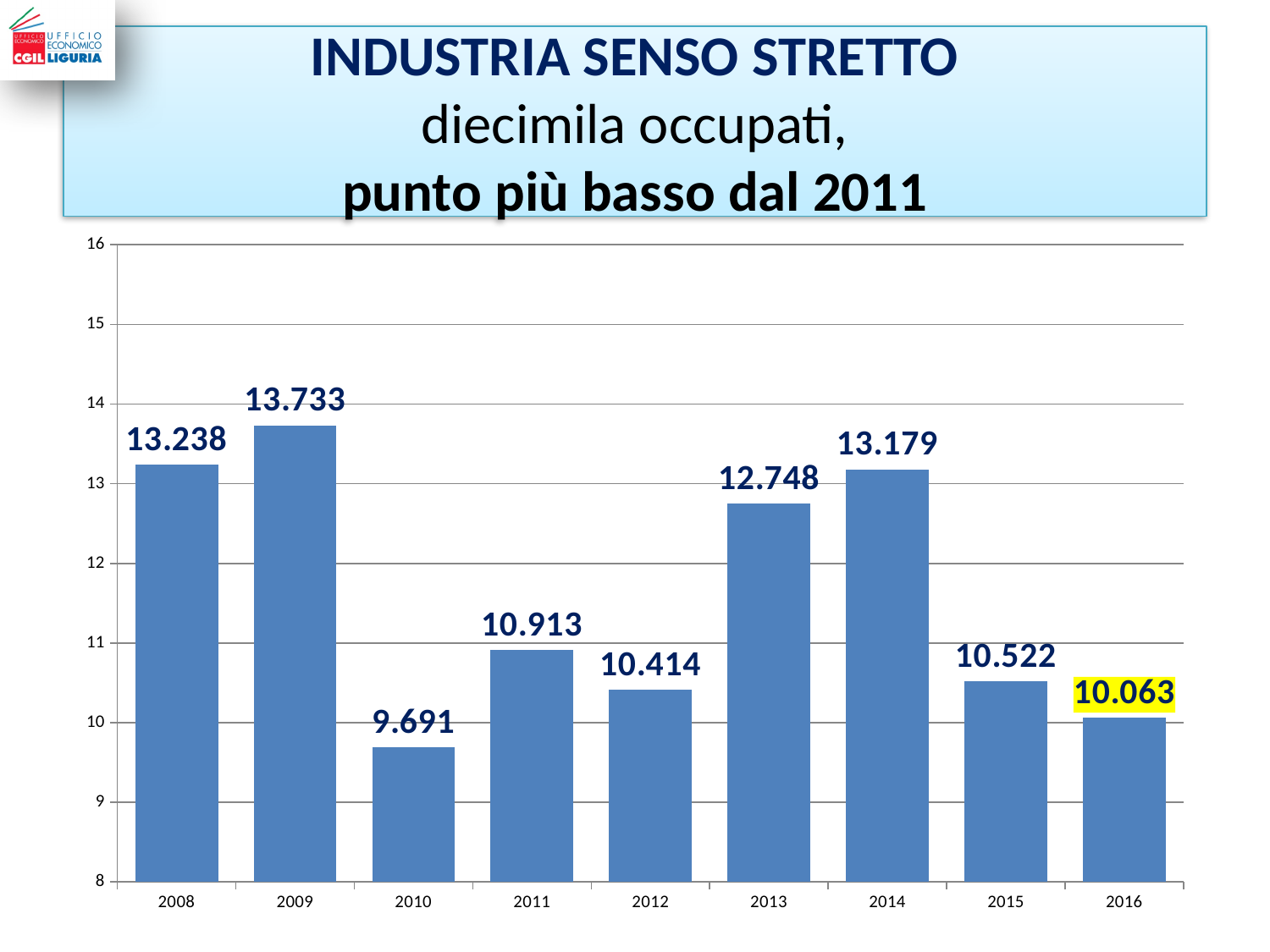
What is the value shown for 2011? 10.913 Do the values rise or fall from 2014 to 2016? fall What kind of chart is shown on the slide? bar chart Is the value for 2013 greater or less than 12? greater What is the value shown for 2016? 10.063 Which is larger, the value for 2012 or the value for 2015? 2015 Which is larger, the value for 2008 or the value for 2014? 2008 Which year has the highest value? 2009 How many years are shown on the x axis? 9 What is the value shown for 2013? 12.748 Which year has the lowest value? 2010 What is the value shown for 2009? 13.733